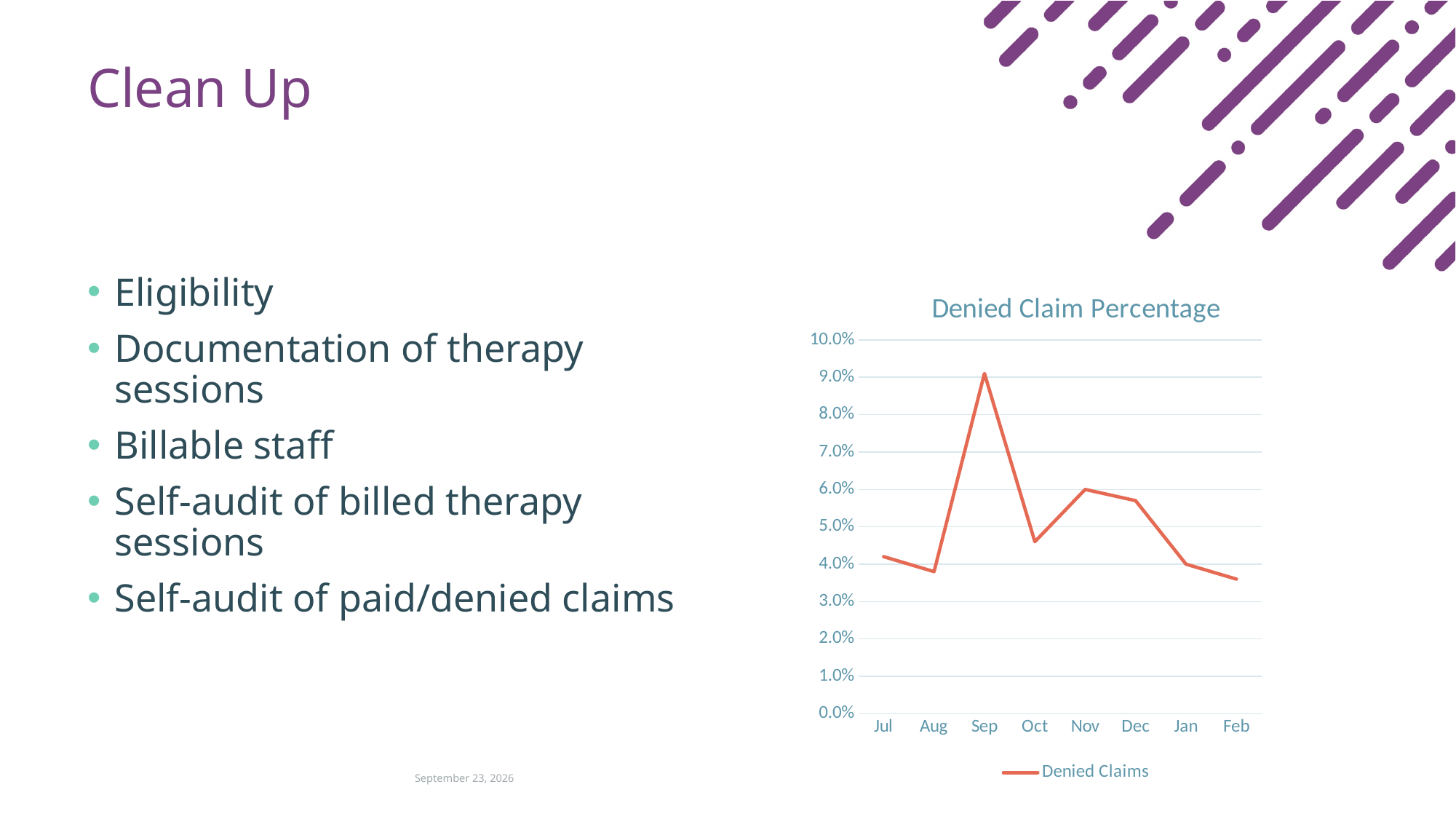
Is the value for Dec greater or less than 5.0%? greater Is the value for Oct greater or less than 5.0%? less In which month is the denied claim percentage highest? Sep What is the title of the chart? Denied Claim Percentage What is the name of the series shown in the legend? Denied Claims Does the denied claim percentage rise or fall from Nov to Feb? fall What kind of chart is shown on the slide? line chart Is the value for Aug greater or less than 4.0%? less How many months are plotted on the x axis? 8 How many series does the legend list? 1 Which month has the larger denied claim percentage, Sep or Oct? Sep